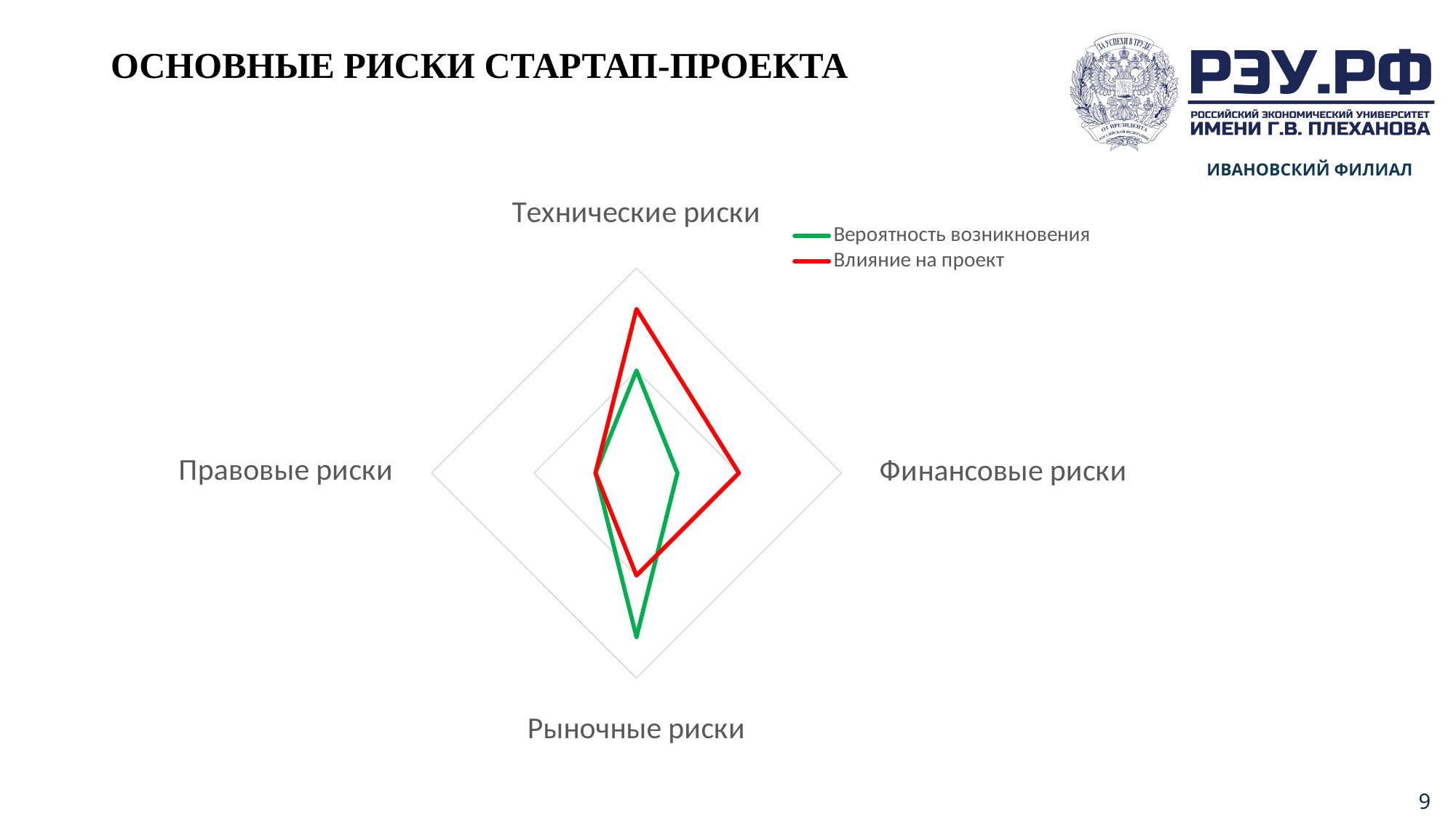
For which category is the 'Вероятность возникновения' series highest? Рыночные риски Which colour represents the 'Влияние на проект' series? Red For 'Технические риски', which series has the larger value: 'Вероятность возникновения' or 'Влияние на проект'? Влияние на проект How many risk categories are plotted on the radar chart? 4 For which category is the 'Влияние на проект' series lowest? Правовые риски What is the title of the slide containing the chart? ОСНОВНЫЕ РИСКИ СТАРТАП-ПРОЕКТА For 'Финансовые риски', which series has the larger value: 'Вероятность возникновения' or 'Влияние на проект'? Влияние на проект For 'Рыночные риски', which series has the larger value: 'Вероятность возникновения' or 'Влияние на проект'? Вероятность возникновения For which category is the 'Влияние на проект' series highest? Технические риски What kind of chart is shown on the slide? Radar chart How many series does the legend list? 2